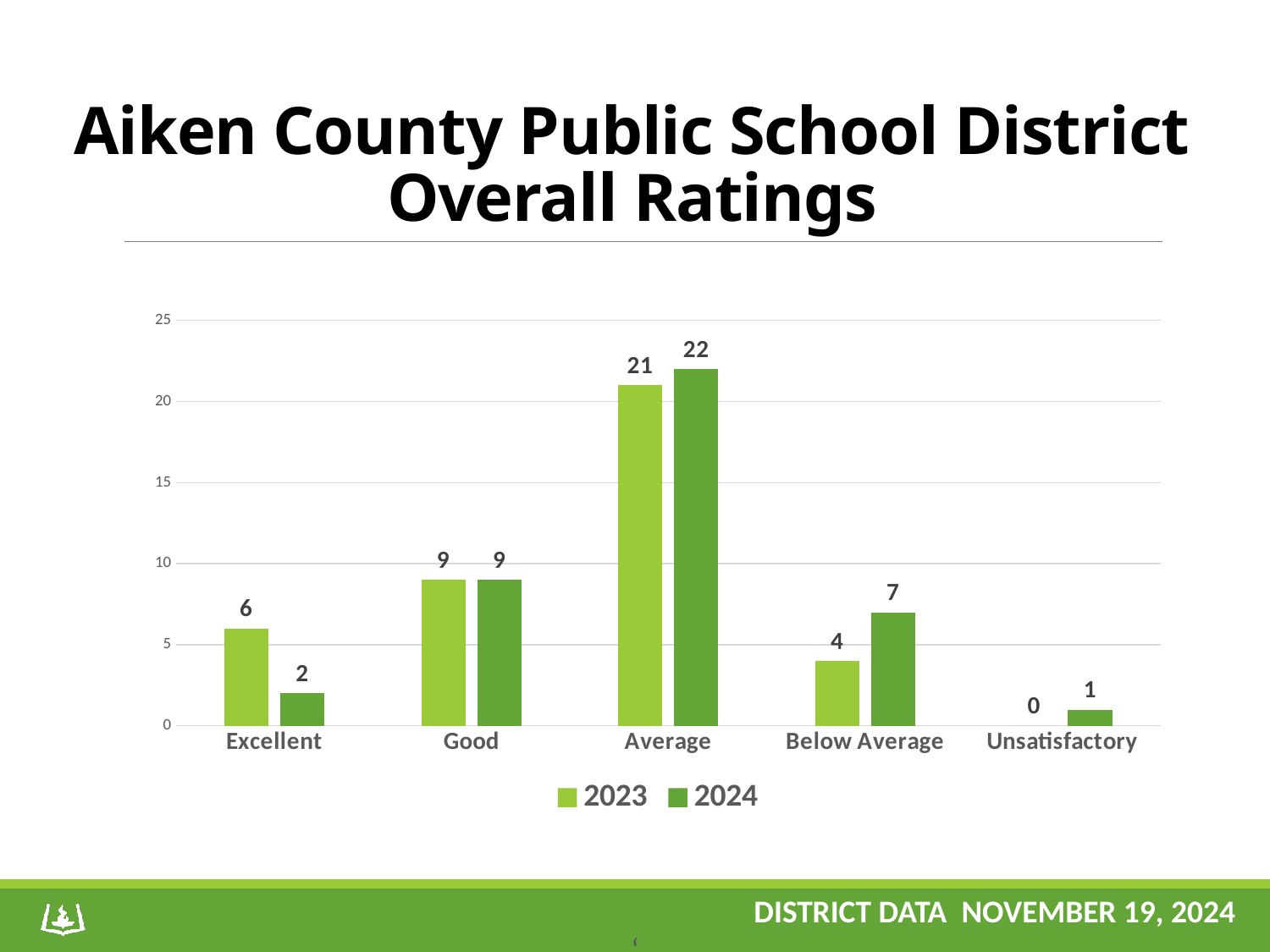
How many rating categories are shown on the x axis? 5 Which category has the highest 2024 value? Average How many series does the legend list? 2 Which category has the lowest 2023 value? Unsatisfactory What is the 2024 value for Unsatisfactory? 1 What kind of chart is shown on the slide? bar chart Is the 2024 value for Average greater or less than 20? greater Which is larger, the 2023 value for Excellent or the 2024 value for Excellent? 2023 What is the difference between the 2024 and 2023 values for Below Average? 3 What is the 2023 value for Excellent? 6 What is the title of the slide? Aiken County Public School District Overall Ratings What is the 2024 value for Below Average? 7